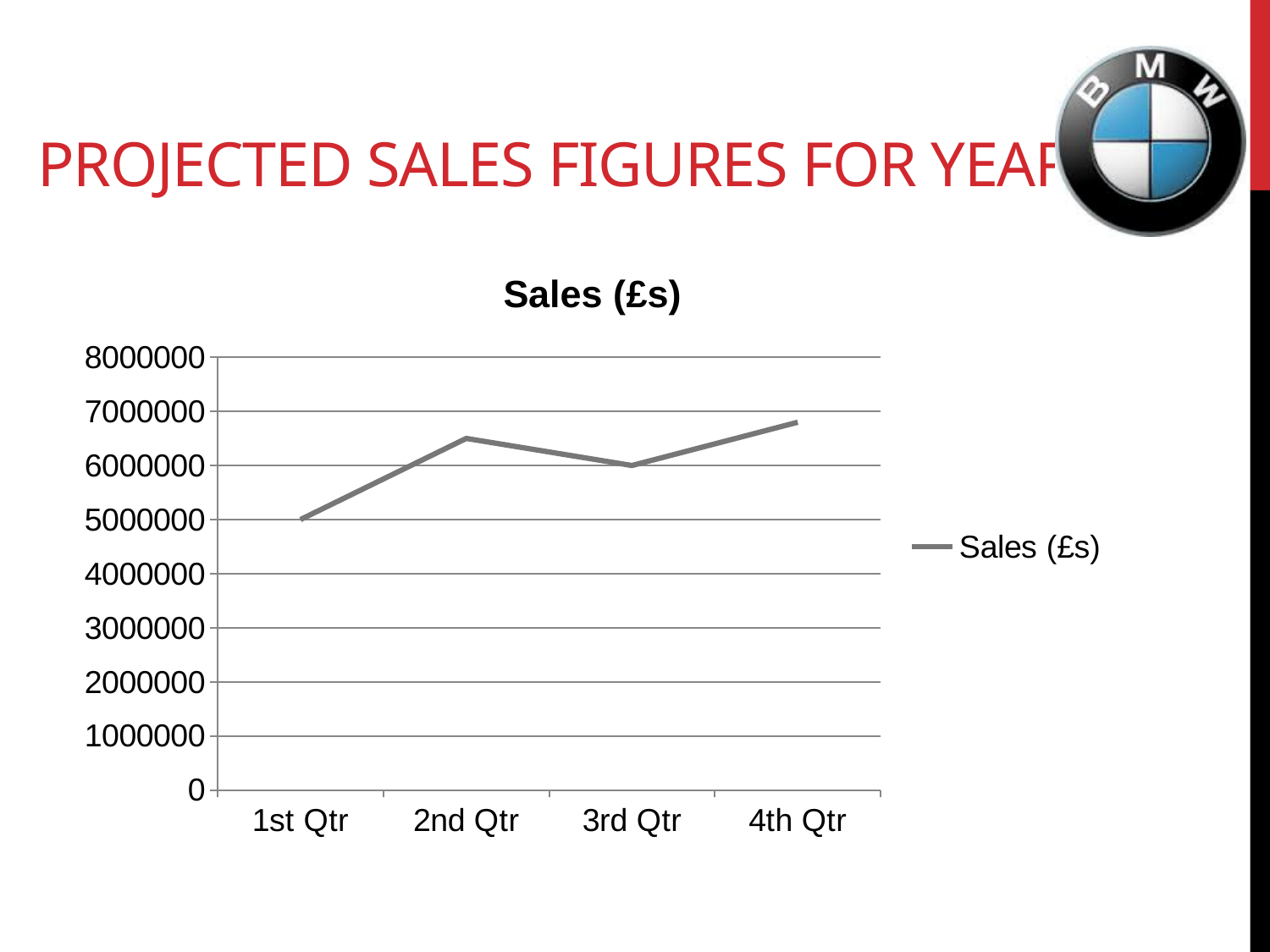
Which is larger, the value for 2nd Qtr or the value for 3rd Qtr? 2nd Qtr Does the value rise or fall from 2nd Qtr to 3rd Qtr? fall Is the value for 4th Qtr greater or less than 7000000? less Which quarter has the highest sales value? 4th Qtr How many quarters are plotted along the x axis? 4 What is the value for 3rd Qtr? 6000000 What is the title of the chart? Sales (£s) What is the value for 1st Qtr? 5000000 How many series does the legend list? 1 Is the value for 2nd Qtr greater or less than 6000000? greater What kind of chart is shown on the slide? line chart Which quarter has the lowest sales value? 1st Qtr